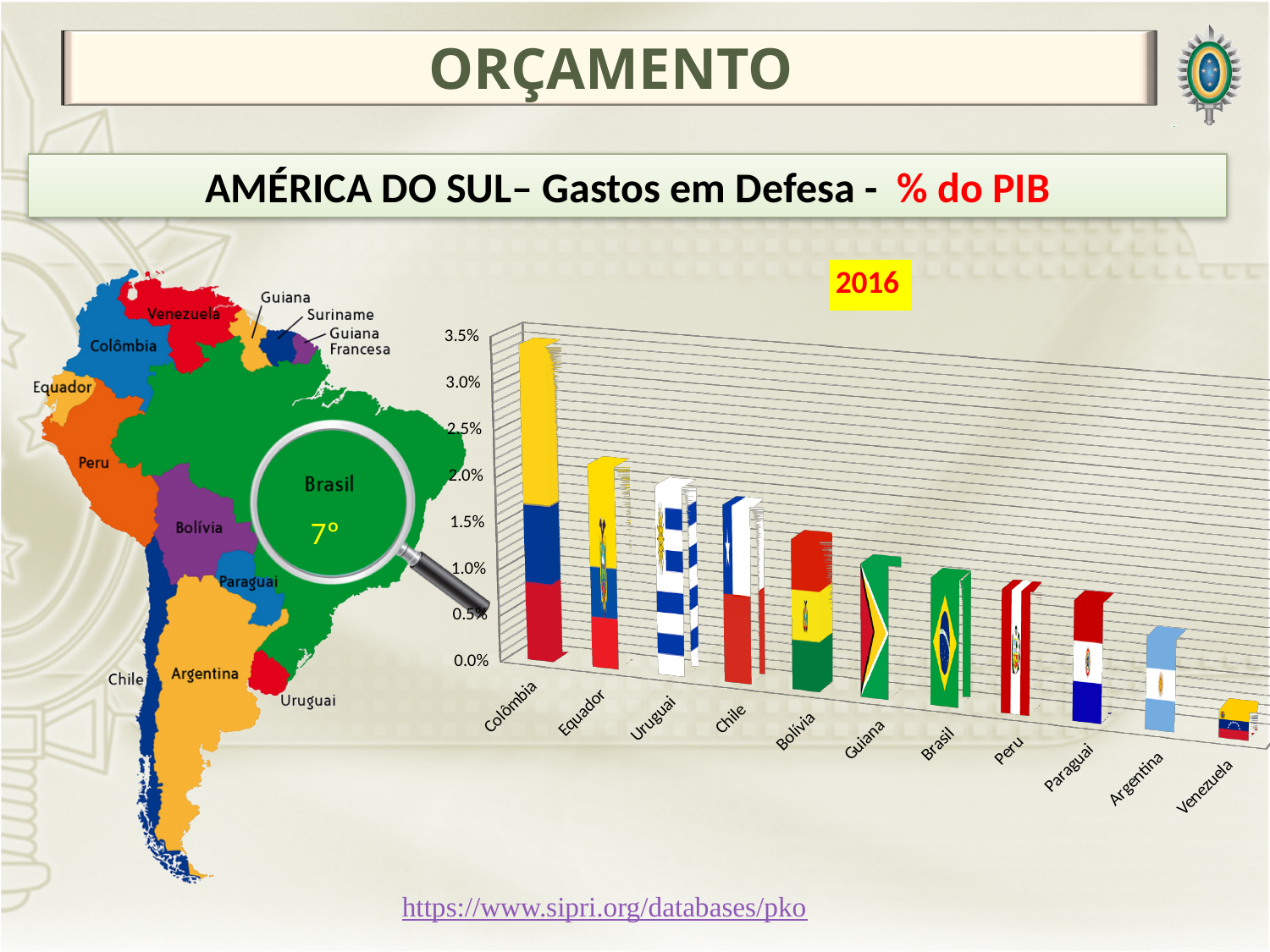
Which country has the highest defense spending as % of GDP in the chart? Colômbia Which year does the chart refer to? 2016 Is the value for Venezuela greater or less than 1.0%? less Which has the larger value, Chile or Argentina? Chile Do the bar values rise or fall from left to right along the x axis? fall Which has the larger value, Colômbia or Brasil? Colômbia What kind of chart is shown on the slide? bar chart Is the value for Brasil greater or less than 2.0%? less How many countries are shown on the x axis of the chart? 11 Is the value for Colômbia greater or less than 2.5%? greater Which country has the lowest defense spending as % of GDP in the chart? Venezuela